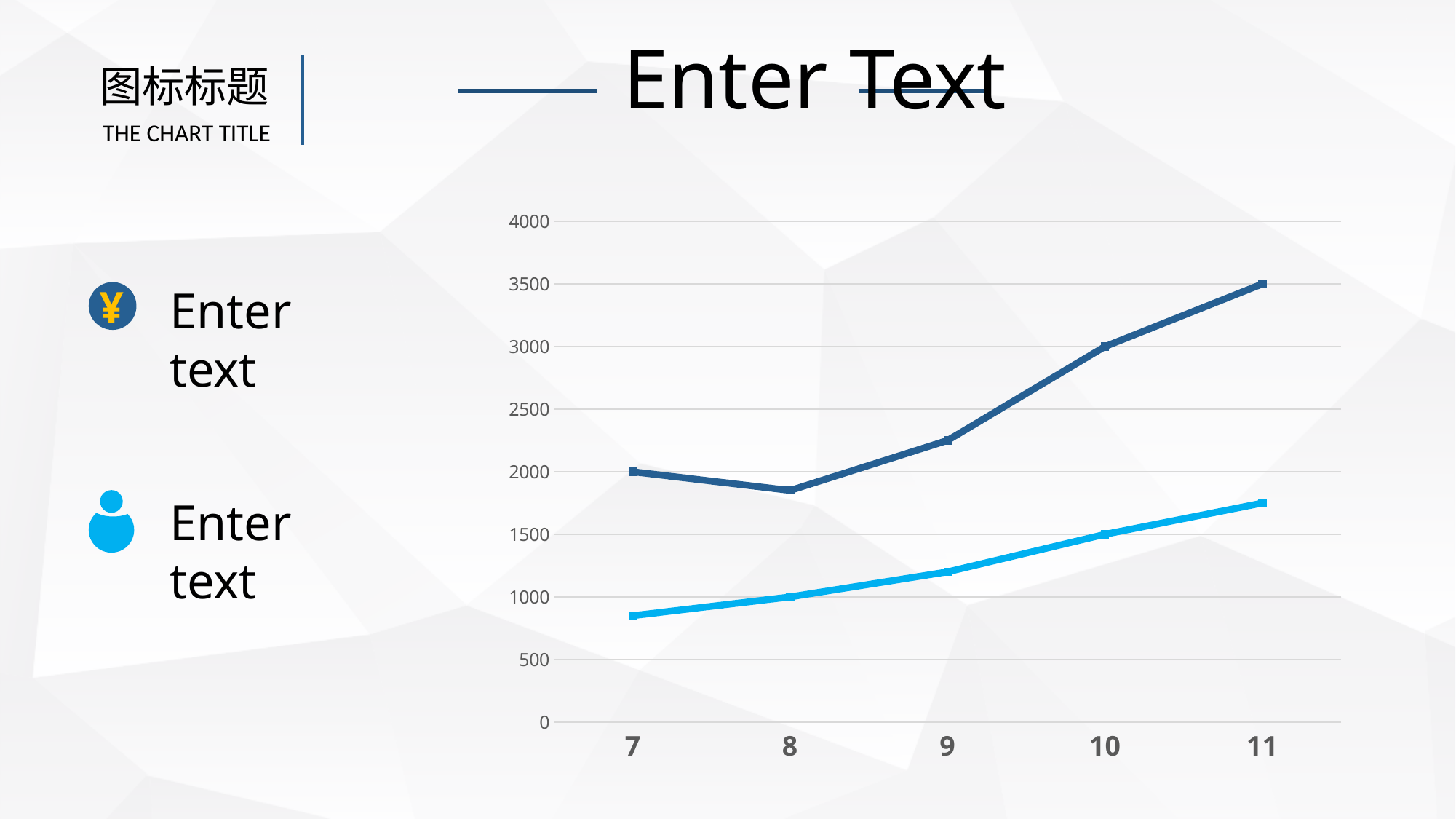
At which x value does the dark blue line reach its highest point? 11 What is the value of the light blue line at x = 8? 1000 At which x value is the dark blue line at its lowest? 8 What is the value of the light blue line at x = 10? 1500 What is the value of the dark blue line at x = 11? 3500 Is the value of the light blue line at x = 11 greater or less than 2000? less How many points are plotted along the x axis of the chart? 5 What is the value of the dark blue line at x = 10? 3000 How many lines are plotted on the chart? 2 What is the value of the dark blue line at x = 7? 2000 What kind of chart is shown on the slide? line chart Which line has the higher value at x = 9, the dark blue line or the light blue line? dark blue line